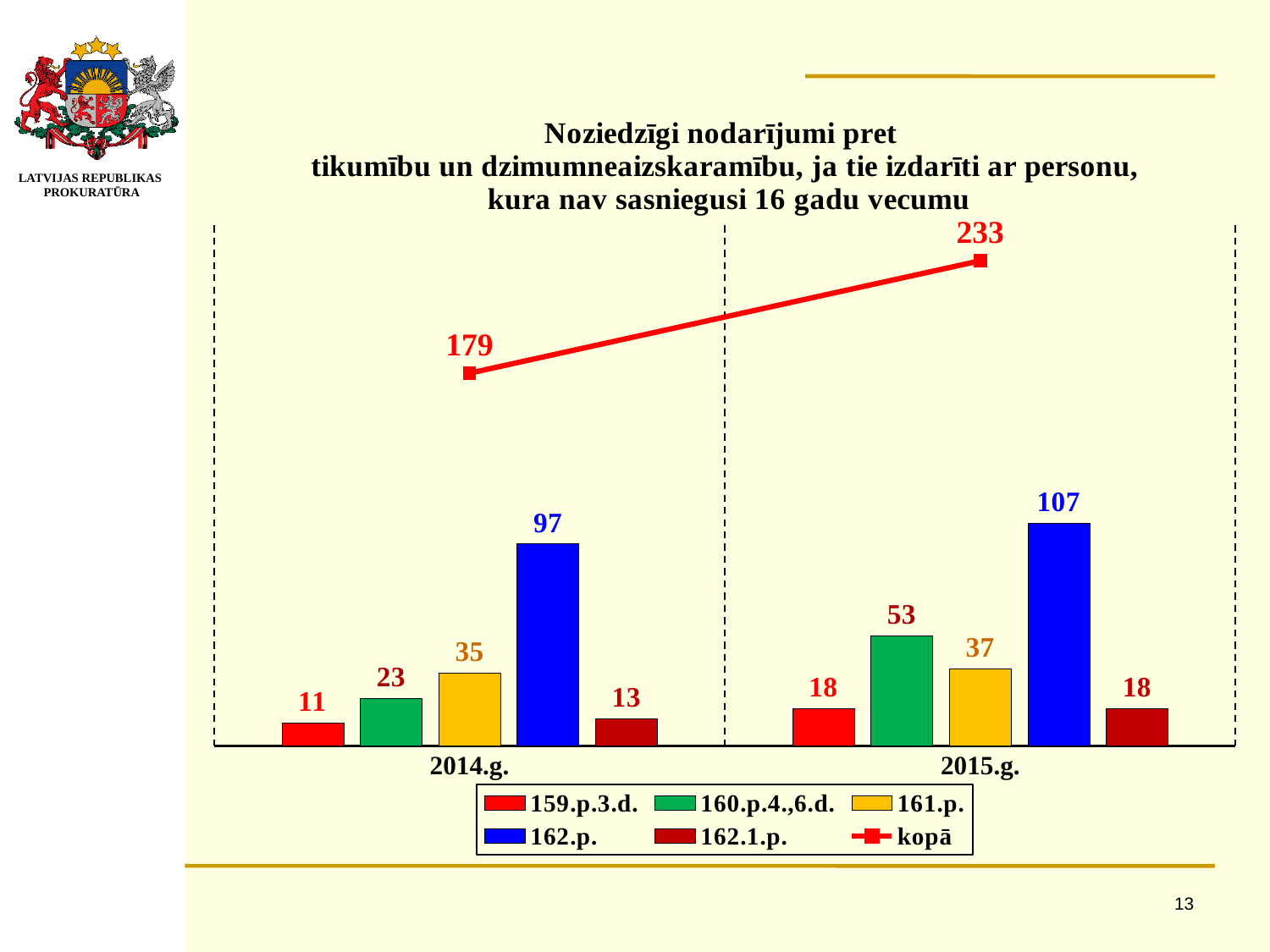
How many year categories are shown on the x axis? 2 What is the difference between the 162.p. values in 2015.g. and 2014.g.? 10 By how much did the kopā value change from 2014.g. to 2015.g.? 54 What is the value of the kopā line in 2015.g.? 233 Which is larger: 161.p. in 2014.g. or 161.p. in 2015.g.? 161.p. in 2015.g. Which series has the highest bar in 2015.g.? 162.p. How many series does the legend list? 6 What is the value for 159.p.3.d. in 2014.g.? 11 Which series has the lowest bar in 2014.g.? 159.p.3.d. What is the value for 160.p.4.,6.d. in 2015.g.? 53 What is the value for 162.p. in 2014.g.? 97 Does the kopā line rise or fall from 2014.g. to 2015.g.? rise